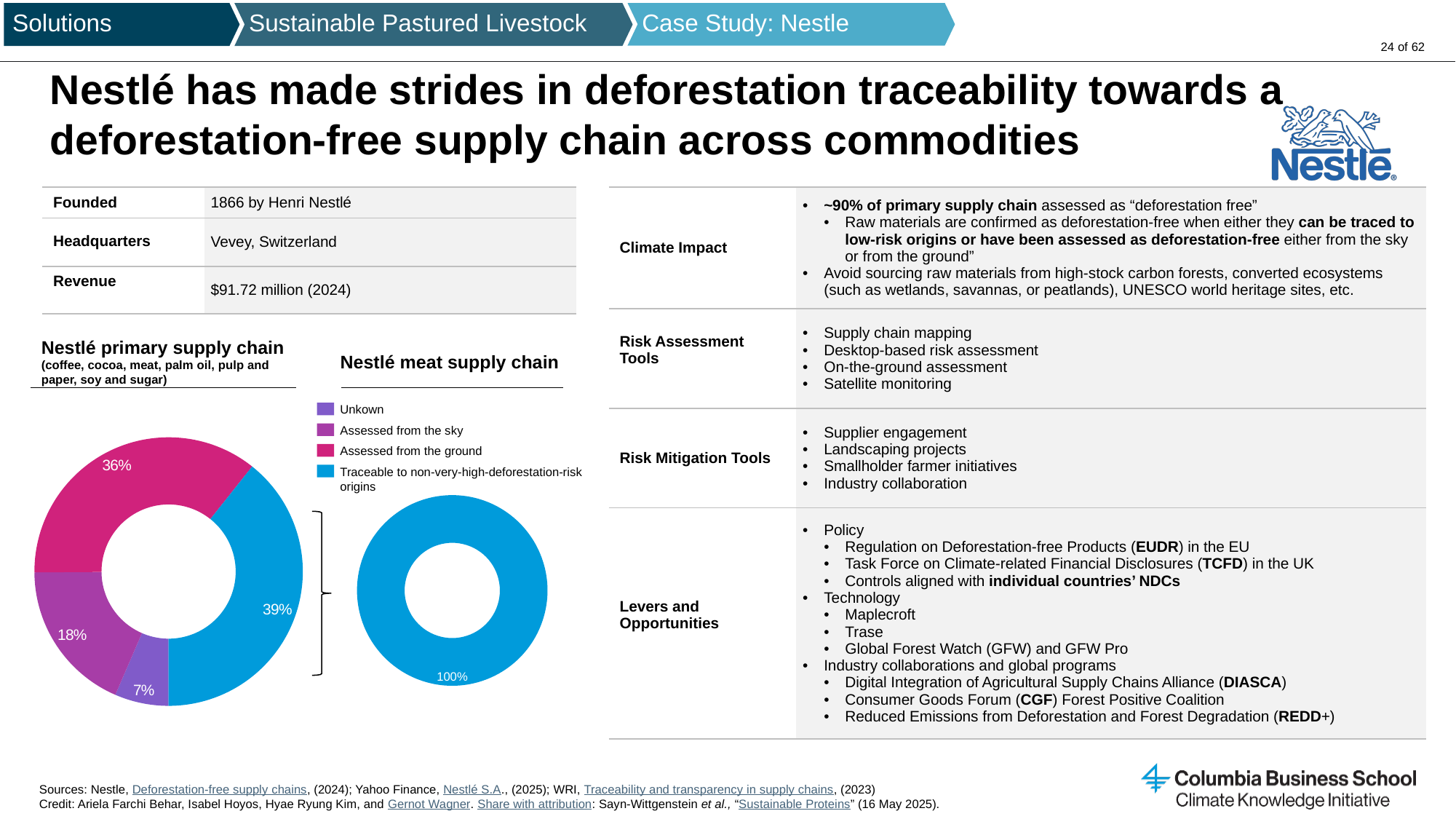
In the Nestlé primary supply chain chart, what is the difference between the share assessed from the ground and the share assessed from the sky? 18% In the Nestlé primary supply chain chart, what share is assessed from the sky? 18% In the Nestlé primary supply chain chart, which category has the smallest share? Unkown In the Nestlé primary supply chain chart, what share is traceable to non-very-high-deforestation-risk origins? 39% In the Nestlé primary supply chain chart, what share is assessed from the ground? 36% How many slices does the Nestlé primary supply chain chart have? 4 In the Nestlé meat supply chain chart, what share is traceable to non-very-high-deforestation-risk origins? 100% In the Nestlé primary supply chain chart, which category has the largest share? Traceable to non-very-high-deforestation-risk origins In the Nestlé primary supply chain chart, which is larger: the share assessed from the sky or the unknown share? Assessed from the sky How many entries does the legend shared by the two supply chain charts list? 4 In the Nestlé primary supply chain chart, what share is unknown? 7% What type of chart is the Nestlé meat supply chain chart? Donut (pie) chart